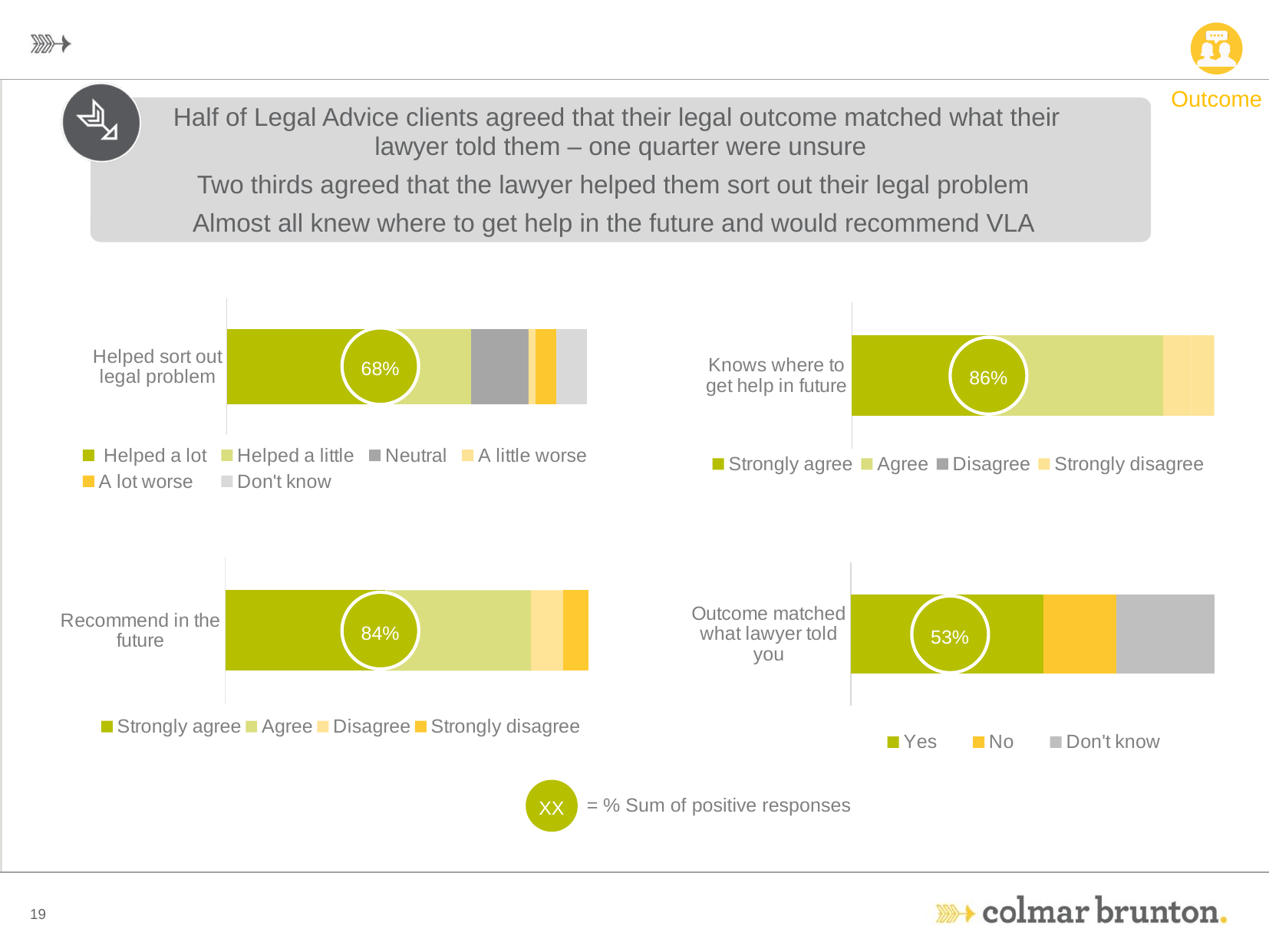
How many series does the legend of the 'Outcome matched what lawyer told you' chart list? 3 Across the four charts, which item has the highest sum of positive responses? Knows where to get help in future Across the four charts, which item has the lowest sum of positive responses? Outcome matched what lawyer told you Which has a larger sum of positive responses: 'Helped sort out legal problem' or 'Outcome matched what lawyer told you'? Helped sort out legal problem In the 'Outcome matched what lawyer told you' chart, which response category is shown in grey? Don't know In the 'Helped sort out legal problem' chart, what is the percentage sum of positive responses shown in the circle? 68% In the 'Recommend in the future' chart, what is the percentage sum of positive responses shown in the circle? 84% What is the difference between the positive response sum for 'Knows where to get help in future' and for 'Recommend in the future'? 2 percentage points In the 'Outcome matched what lawyer told you' chart, what is the percentage sum of positive responses shown in the circle? 53% How many series does the legend of the 'Helped sort out legal problem' chart list? 6 In the 'Knows where to get help in future' chart, what is the percentage sum of positive responses shown in the circle? 86% What kind of chart is the 'Recommend in the future' chart? Stacked bar chart